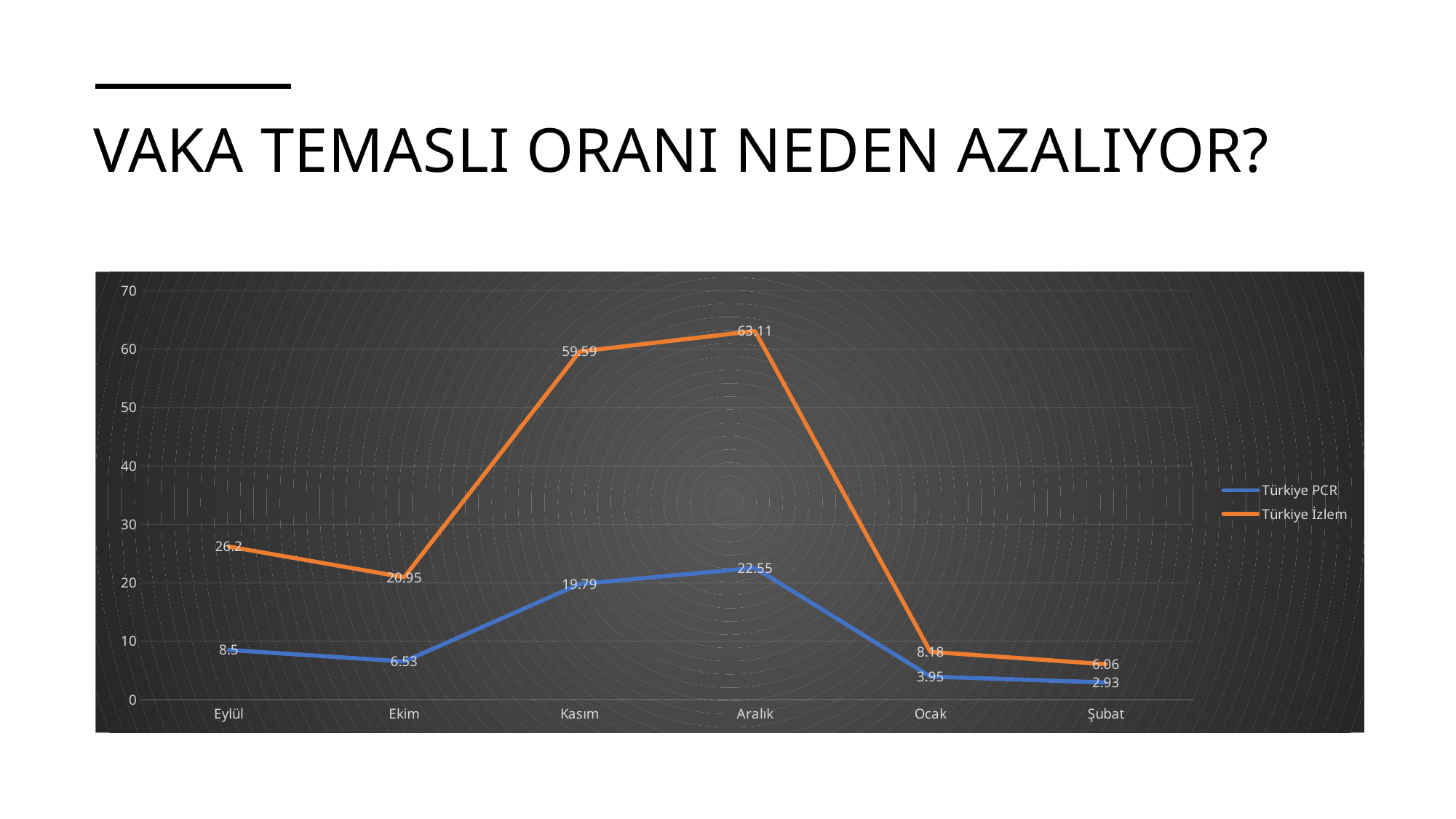
In which month is the Türkiye PCR series lowest? Şubat How many series does the legend list? 2 Does the Türkiye PCR series rise or fall from Aralık to Şubat? Fall What is the difference between Türkiye İzlem and Türkiye PCR in Aralık? 40.56 Which is larger in Ocak: Türkiye PCR or Türkiye İzlem? Türkiye İzlem What kind of chart is shown on the slide? Line chart How many months are shown on the x axis? 6 In which month is the Türkiye İzlem series highest? Aralık What is the value for Türkiye PCR in Kasım? 19.79 What is the value for Türkiye PCR in Şubat? 2.93 What is the value for Türkiye İzlem in Aralık? 63.11 What is the value for Türkiye İzlem in Eylül? 26.2